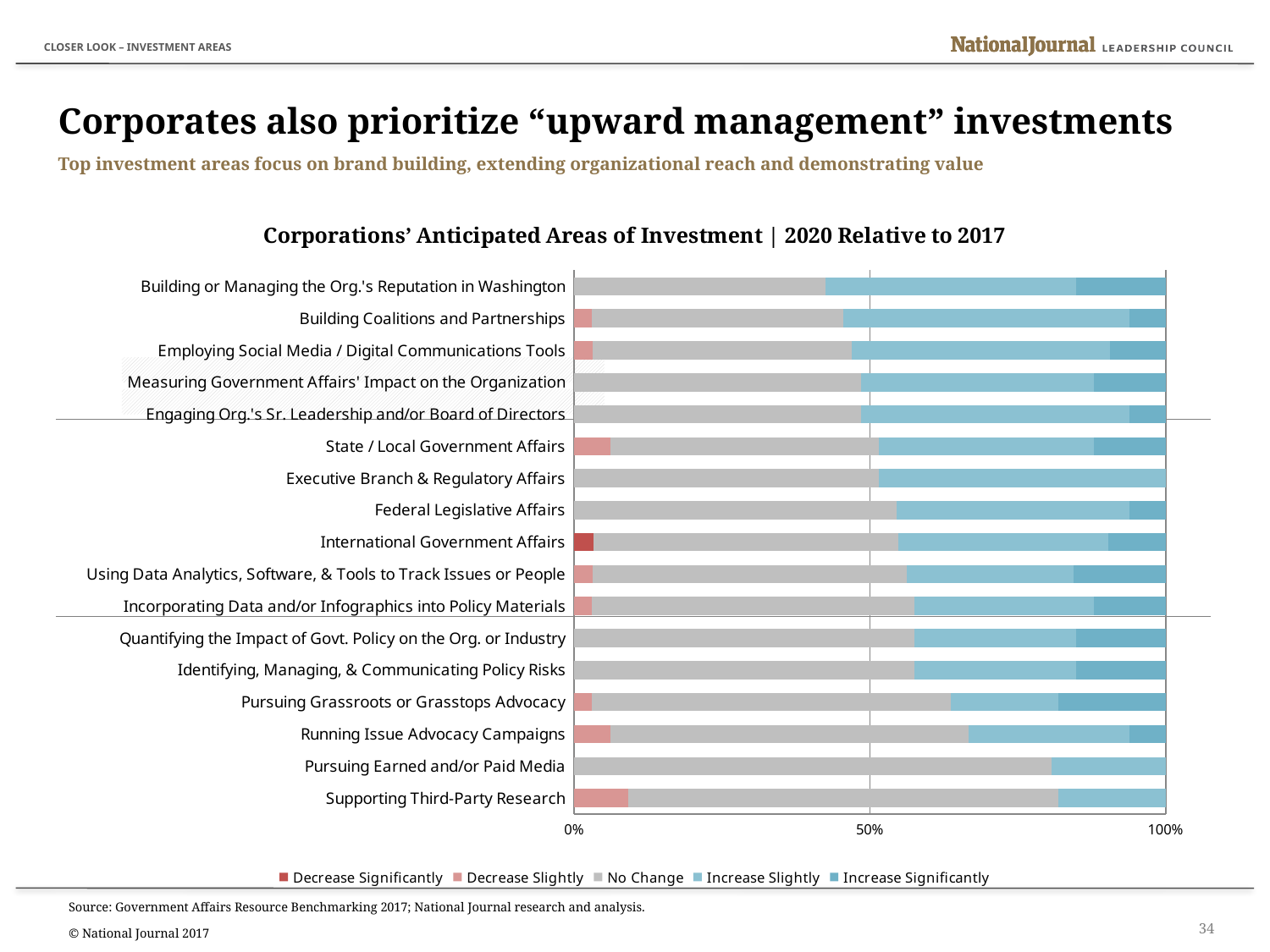
What kind of chart is shown on the slide? Stacked bar chart Is the 'No Change' value for Pursuing Earned and/or Paid Media greater or less than 50%? greater Is the 'No Change' value for Building or Managing the Org.'s Reputation in Washington greater or less than 50%? less Which category has the largest 'Decrease Slightly' segment? Supporting Third-Party Research Is the 'No Change' value for Running Issue Advocacy Campaigns greater or less than 50%? greater How many series does the legend list? 5 How many investment areas (categories) are plotted in the chart? 17 Which has the larger 'No Change' segment: Supporting Third-Party Research or Building or Managing the Org.'s Reputation in Washington? Supporting Third-Party Research Which category is the only one with a 'Decrease Significantly' segment? International Government Affairs Which has the larger 'Decrease Slightly' segment: Supporting Third-Party Research or Building Coalitions and Partnerships? Supporting Third-Party Research What is the title of the chart? Corporations' Anticipated Areas of Investment | 2020 Relative to 2017